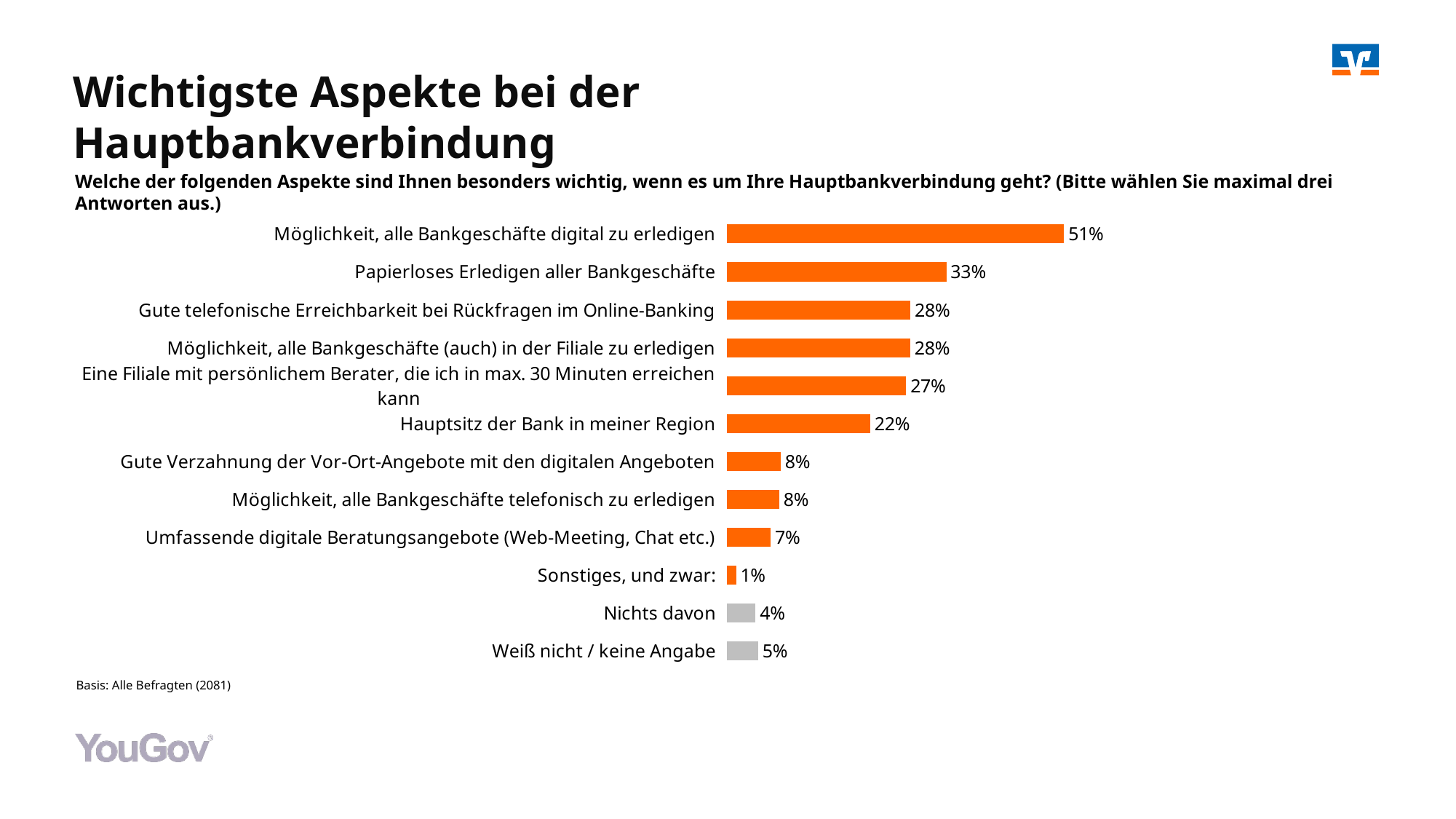
What is the base (number of respondents) stated below the chart? 2081 What is the value for "Weiß nicht / keine Angabe"? 5% Which category has the lowest value? Sonstiges, und zwar: What percentage of respondents chose "Möglichkeit, alle Bankgeschäfte digital zu erledigen"? 51% What is the value for "Hauptsitz der Bank in meiner Region"? 22% Which categories are shown with grey bars instead of orange? Nichts davon and Weiß nicht / keine Angabe What type of chart is shown on the slide? Bar chart Which category has the highest value? Möglichkeit, alle Bankgeschäfte digital zu erledigen How many categories are shown in the chart? 12 Which is larger: "Hauptsitz der Bank in meiner Region" or "Gute Verzahnung der Vor-Ort-Angebote mit den digitalen Angeboten"? Hauptsitz der Bank in meiner Region What is the difference between "Möglichkeit, alle Bankgeschäfte digital zu erledigen" and "Papierloses Erledigen aller Bankgeschäfte"? 18 percentage points What is the difference between "Eine Filiale mit persönlichem Berater, die ich in max. 30 Minuten erreichen kann" and "Umfassende digitale Beratungsangebote (Web-Meeting, Chat etc.)"? 20 percentage points